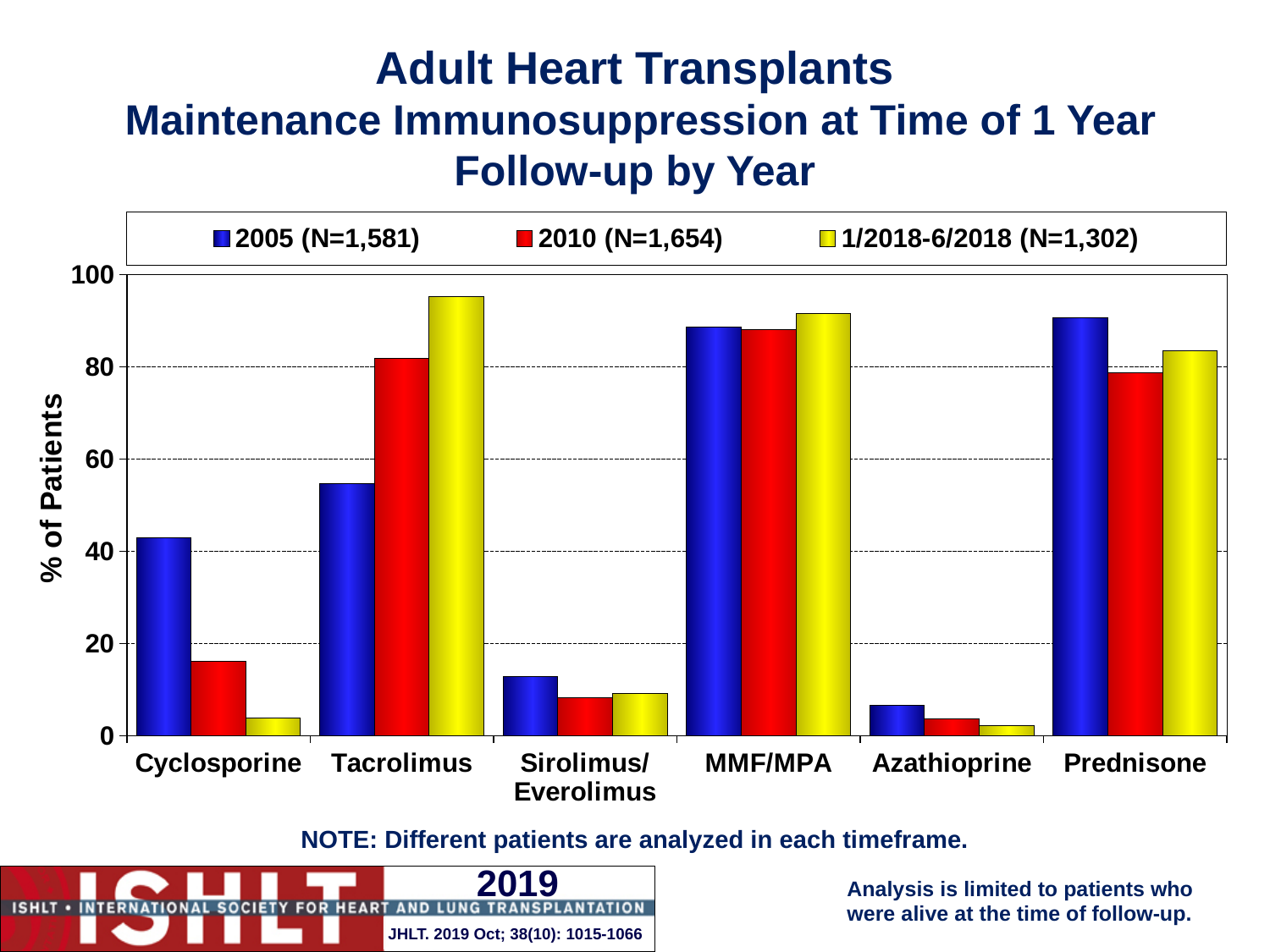
Is the value for Cyclosporine in 2005 greater or less than 40? greater Which drug has the lowest value for 2005? Azathioprine What is the label on the y axis? % of Patients Which drug has the highest value for 1/2018-6/2018? Tacrolimus Does the value for Cyclosporine rise or fall from 2005 to 1/2018-6/2018? fall Is the value for Tacrolimus in 1/2018-6/2018 greater or less than 80? greater Is the value for Azathioprine in 2005 greater or less than 20? less For Cyclosporine, which is larger: the 2005 value or the 2010 value? 2005 For Tacrolimus, which is larger: the 2005 value or the 1/2018-6/2018 value? 1/2018-6/2018 How many drug categories are shown on the x axis? 6 What kind of chart is shown on the slide? bar chart How many series does the legend list? 3